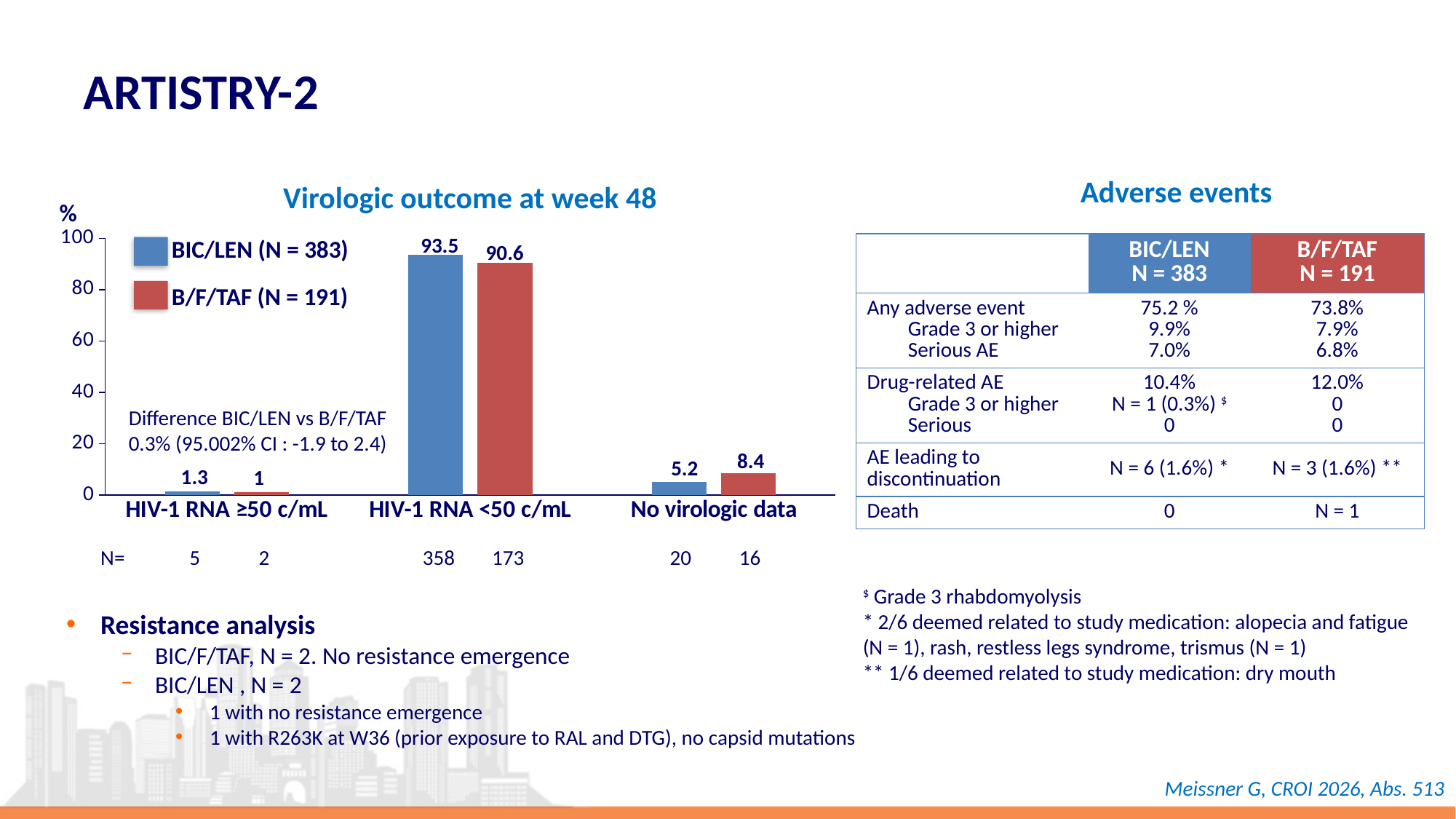
Which category has the highest value for BIC/LEN? HIV-1 RNA <50 c/mL What is the difference between BIC/LEN and B/F/TAF in the HIV-1 RNA <50 c/mL category? 2.9 What is the value for B/F/TAF in the No virologic data category? 8.4 What is the title of the chart? Virologic outcome at week 48 In the No virologic data category, which series has the larger value, BIC/LEN or B/F/TAF? B/F/TAF What is the value for BIC/LEN in the HIV-1 RNA <50 c/mL category? 93.5 How many series does the chart legend list? 2 How many categories are shown on the x axis of the chart? 3 Which category has the lowest value for B/F/TAF? HIV-1 RNA ≥50 c/mL What kind of chart is shown on the slide? bar chart Is the value for B/F/TAF in the HIV-1 RNA <50 c/mL category greater or less than 80? greater What is the value for B/F/TAF in the HIV-1 RNA ≥50 c/mL category? 1